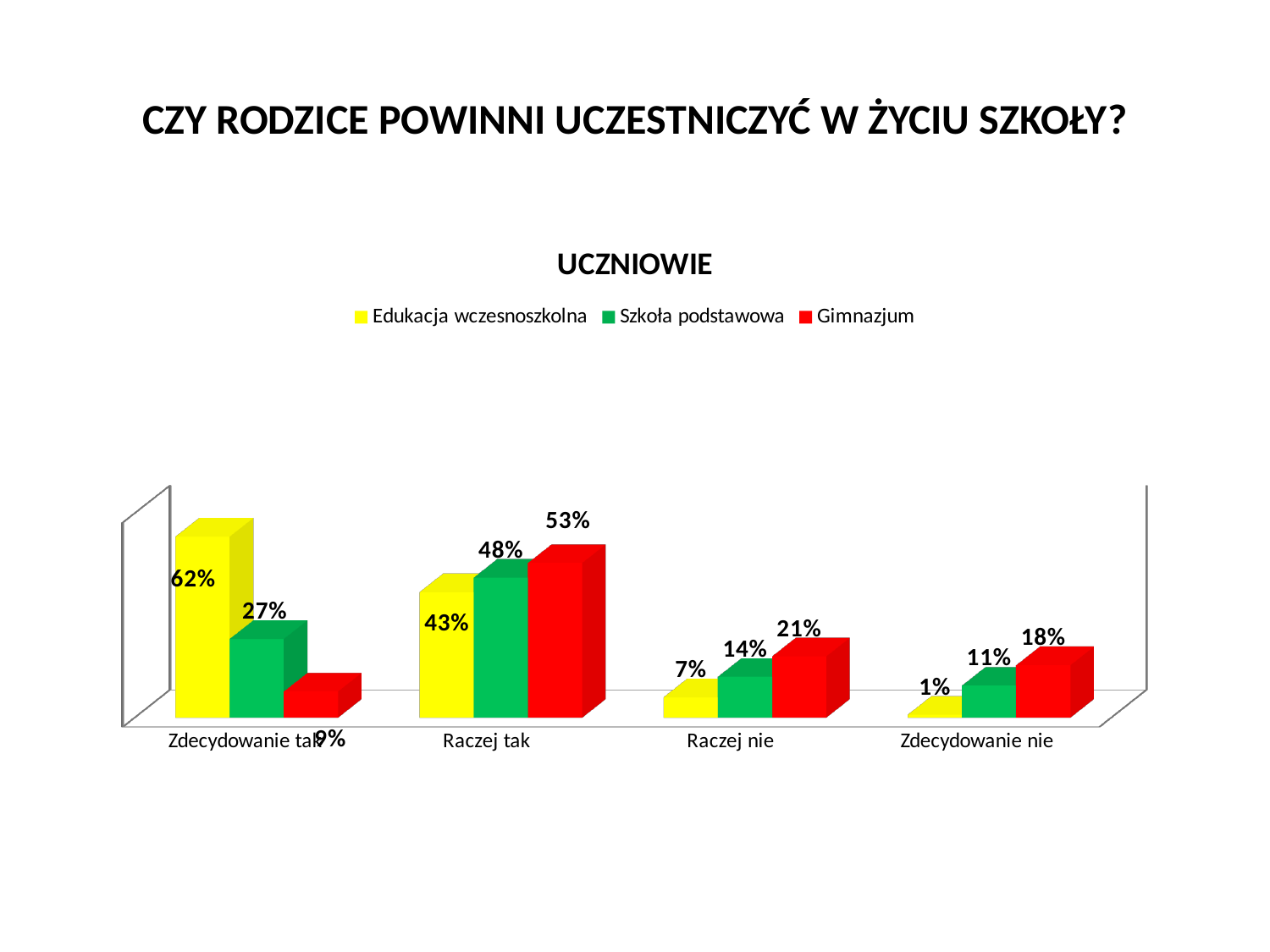
What is the value for Gimnazjum in the Raczej tak category? 53% What is the value for Edukacja wczesnoszkolna in the Zdecydowanie nie category? 1% What type of chart is shown on the slide? bar chart What is the value for Edukacja wczesnoszkolna in the Zdecydowanie tak category? 62% In the Raczej nie category, which is larger: the value for Gimnazjum or the value for Edukacja wczesnoszkolna? Gimnazjum Which category has the highest value for Gimnazjum? Raczej tak How many categories are shown on the x axis? 4 What is the difference between the Edukacja wczesnoszkolna and Szkoła podstawowa values in the Zdecydowanie tak category? 35% What is the title of the chart? UCZNIOWIE Which category has the lowest value for Edukacja wczesnoszkolna? Zdecydowanie nie What is the value for Szkoła podstawowa in the Raczej nie category? 14% How many series does the legend list? 3